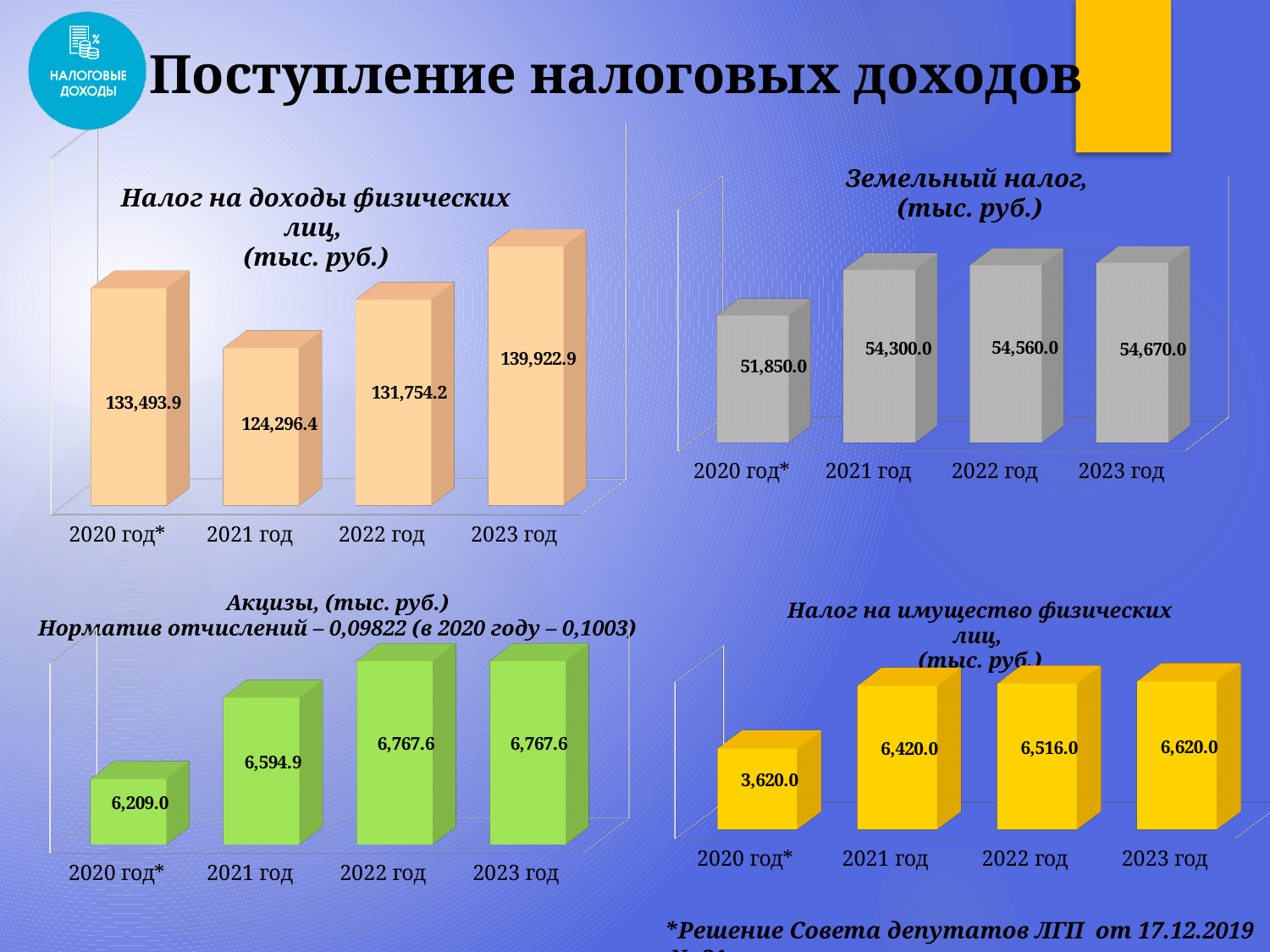
In the top-right chart (Земельный налог), what is the value for 2020 год*? 51,850.0 In the bottom-right chart (Налог на имущество физических лиц), what is the value for 2022 год? 6,516.0 In the bottom-right chart (Налог на имущество физических лиц), which is larger, the value for 2021 год or 2023 год? 2023 год In the top-right chart (Земельный налог), do the values rise or fall from 2020 to 2023? rise In the top-left chart (Налог на доходы физических лиц), what is the value for 2023 год? 139,922.9 In the bottom-left chart (Акцизы), what is the value for 2021 год? 6,594.9 In the top-right chart (Земельный налог), which year has the highest value? 2023 год In the top-left chart (Налог на доходы физических лиц), which year has the lowest value? 2021 год In the bottom-right chart (Налог на имущество физических лиц), what is the difference between the 2021 год and 2020 год* values? 2,800.0 In the bottom-left chart (Акцизы), how many years are plotted? 4 What kind of chart is the top-left chart (Налог на доходы физических лиц)? bar chart In the top-left chart (Налог на доходы физических лиц), what is the difference between the 2023 год and 2021 год values? 15,626.5